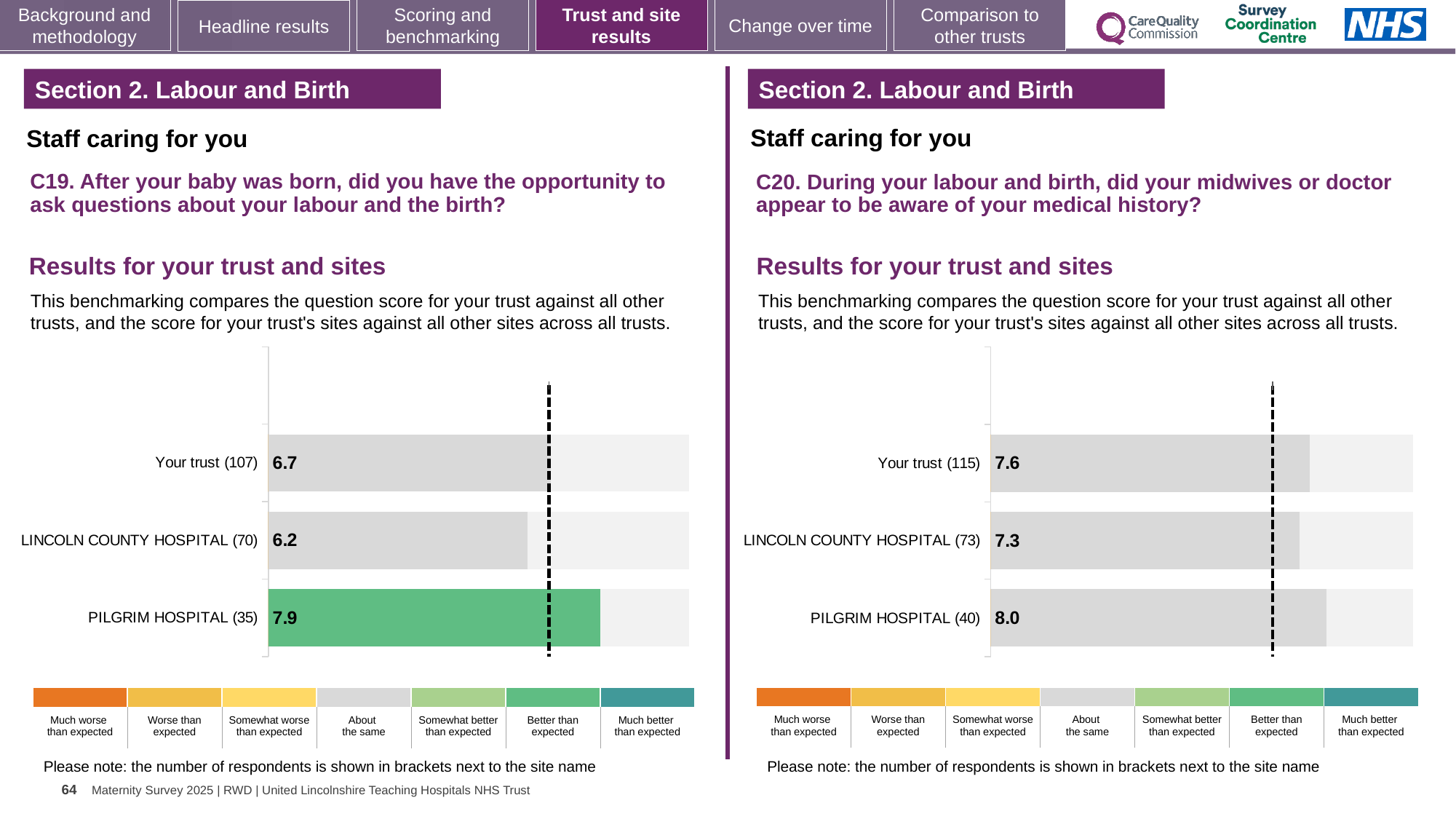
In the C19 chart on the left, what is the difference between the scores for PILGRIM HOSPITAL (35) and LINCOLN COUNTY HOSPITAL (70)? 1.7 In the C20 chart on the right, which site or trust has the lowest score? LINCOLN COUNTY HOSPITAL (73) In the C19 chart on the left, what is the score for LINCOLN COUNTY HOSPITAL (70)? 6.2 In the C19 chart on the left, how many bars are plotted? 3 In the C20 chart on the right, is the score for Your trust (115) or LINCOLN COUNTY HOSPITAL (73) larger? Your trust (115) In the C19 chart on the left, what is the score for Your trust (107)? 6.7 In the C20 chart on the right, what is the score for PILGRIM HOSPITAL (40)? 8.0 In the C19 chart on the left, which site or trust has the lowest score? LINCOLN COUNTY HOSPITAL (70) In the C20 chart on the right, what is the score for Your trust (115)? 7.6 What type of chart is used in the C19 chart on the left? Bar chart In the C19 chart on the left, which site or trust has the highest score? PILGRIM HOSPITAL (35) In the C20 chart on the right, what is the difference between the scores for PILGRIM HOSPITAL (40) and Your trust (115)? 0.4